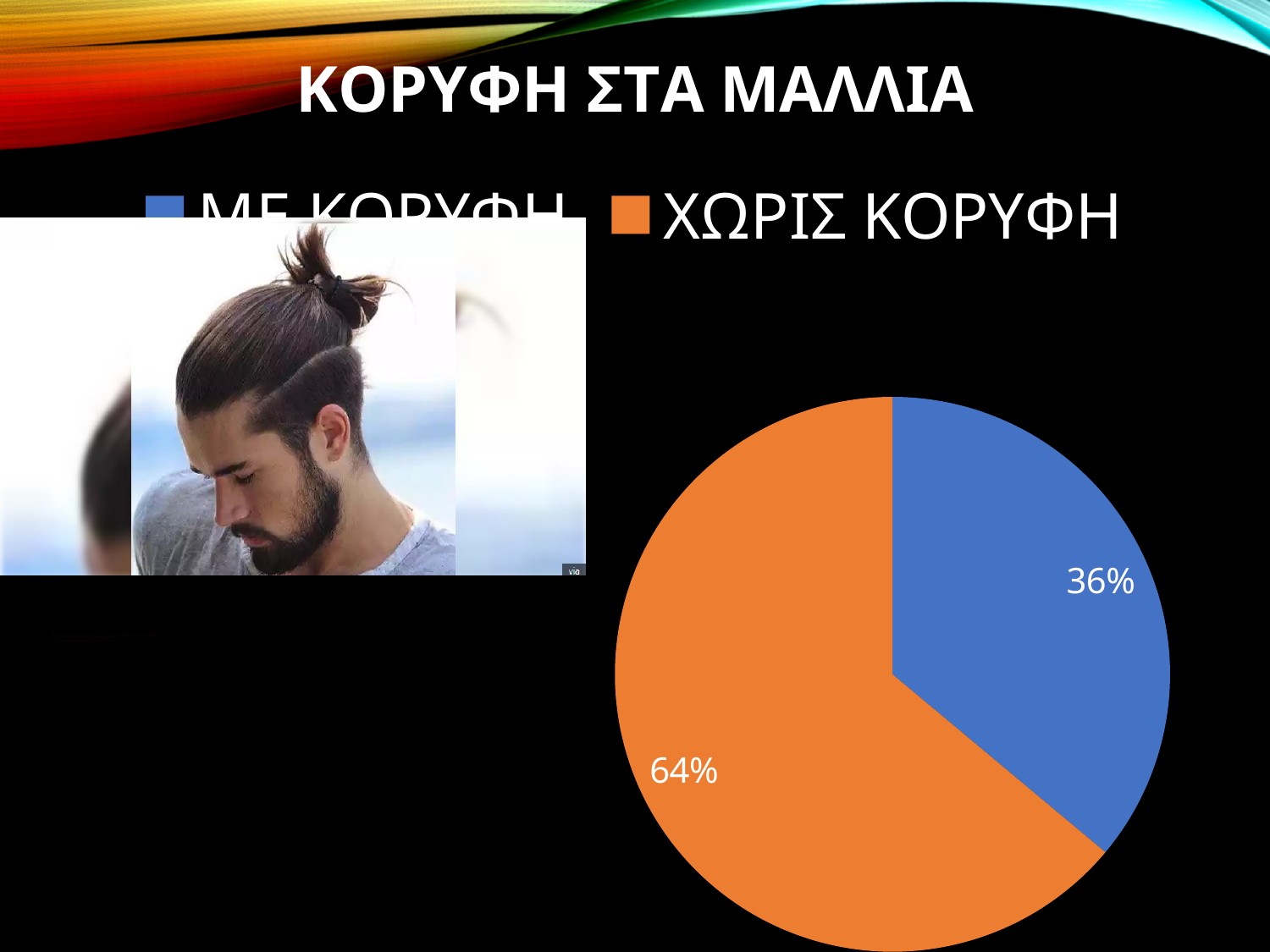
What is the difference in percentage points between ΧΩΡΙΣ ΚΟΡΥΦΗ and ΜΕ ΚΟΡΥΦΗ? 28 Which is larger, the share for ΜΕ ΚΟΡΥΦΗ or the share for ΧΩΡΙΣ ΚΟΡΥΦΗ? ΧΩΡΙΣ ΚΟΡΥΦΗ What percentage is shown for ΧΩΡΙΣ ΚΟΡΥΦΗ? 64% What kind of chart is shown on the slide? pie chart Which category has the smallest share of the pie? ΜΕ ΚΟΡΥΦΗ What is the title of the chart? ΚΟΡΥΦΗ ΣΤΑ ΜΑΛΛΙΑ What percentage is shown for the blue slice (ΜΕ ΚΟΡΥΦΗ)? 36% Which category has the largest share of the pie? ΧΩΡΙΣ ΚΟΡΥΦΗ What colour is the slice for ΧΩΡΙΣ ΚΟΡΥΦΗ? orange What share of the pie does the orange slice represent? 64% How many entries does the legend list? 2 How many slices does the pie chart have? 2